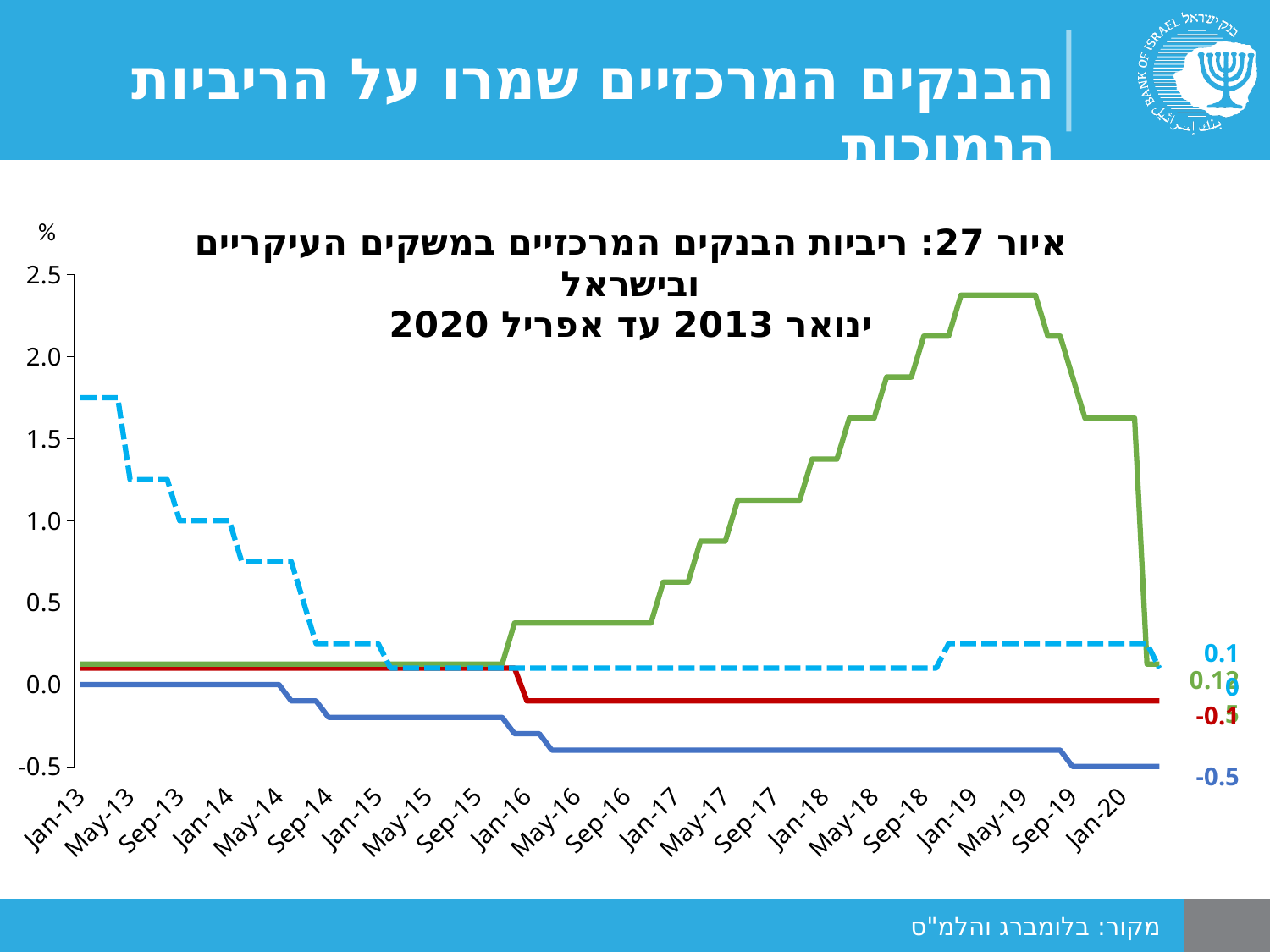
Is the value of the light blue dashed line at Jan-13 greater or less than 1.5? greater What is the difference between the final labelled values of the light blue dashed line (0.1) and the dark blue line (-0.5)? 0.6 How many lines are plotted in the chart? 4 Does the dark blue line rise or fall over the period shown? fall What is the final value labelled for the light blue dashed line at the right end of the chart? 0.1 What unit is shown on the vertical axis of the chart? % What is the final value labelled for the red line at the right end of the chart? -0.1 What is the final value labelled for the dark blue line at the right end of the chart? -0.5 What type of chart is shown on the slide? line chart Which line reaches the highest value anywhere in the chart? the green line Is the peak value of the green line greater or less than 2.0? greater Which line has the lowest value at the end of the period? the dark blue line